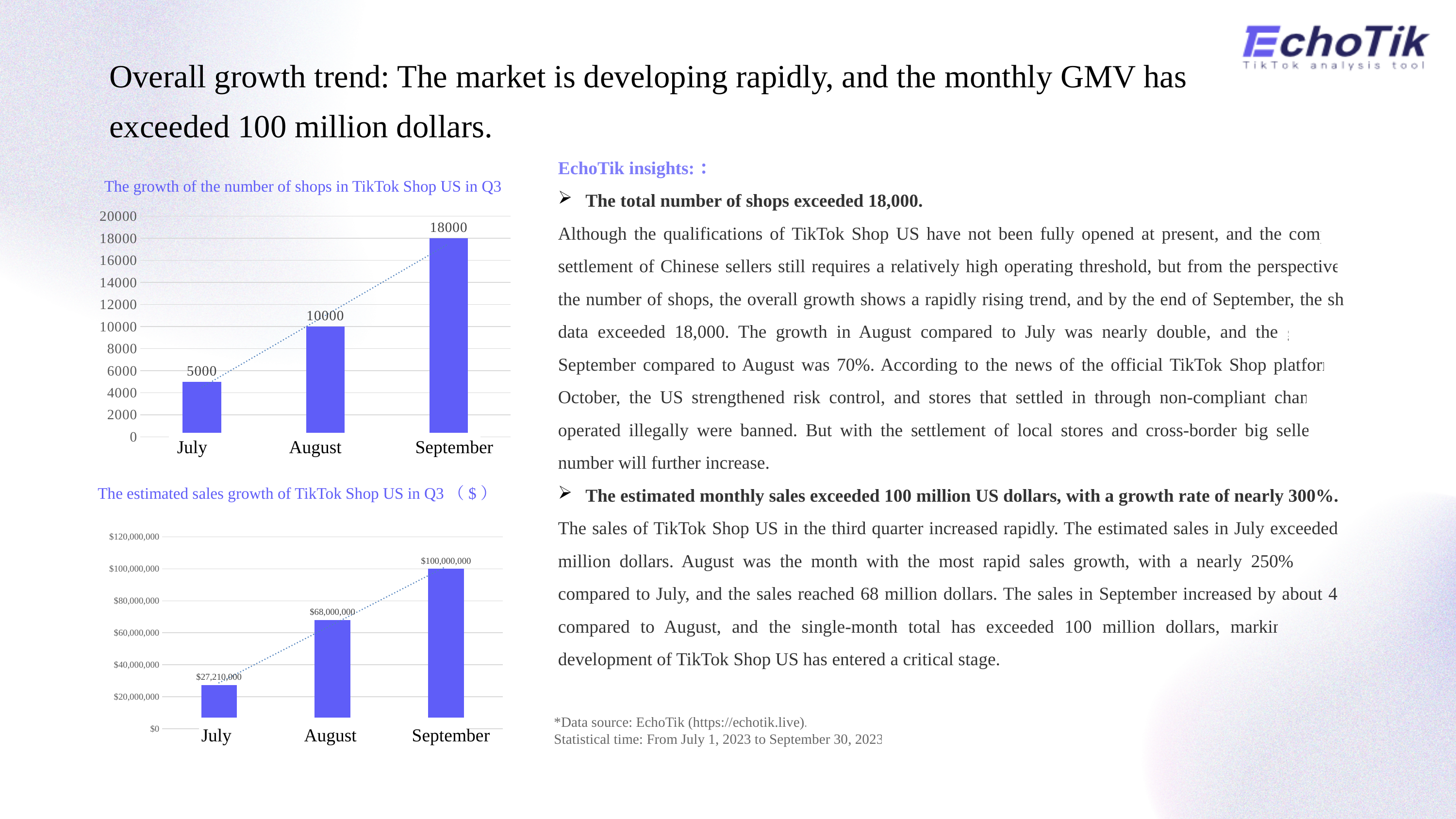
In the chart 'The estimated sales growth of TikTok Shop US in Q3 ($)', what is the value for July? $27,210,000 In the chart 'The estimated sales growth of TikTok Shop US in Q3 ($)', what is the difference between the September and August values? $32,000,000 In the chart 'The growth of the number of shops in TikTok Shop US in Q3', do the values rise or fall from July to September? rise In the chart 'The estimated sales growth of TikTok Shop US in Q3 ($)', which is larger, the value for August or the value for July? August In the chart 'The estimated sales growth of TikTok Shop US in Q3 ($)', what is the value for September? $100,000,000 In the chart 'The estimated sales growth of TikTok Shop US in Q3 ($)', is the value for August greater or less than $60,000,000? greater In the chart 'The growth of the number of shops in TikTok Shop US in Q3', which month has the lowest value? July In the chart 'The growth of the number of shops in TikTok Shop US in Q3', what is the value for August? 10000 In the chart 'The growth of the number of shops in TikTok Shop US in Q3', what is the difference between the September and July values? 13000 In the chart 'The growth of the number of shops in TikTok Shop US in Q3', which month has the highest value? September What kind of chart is 'The estimated sales growth of TikTok Shop US in Q3 ($)'? bar chart In the chart 'The growth of the number of shops in TikTok Shop US in Q3', how many months are shown? 3